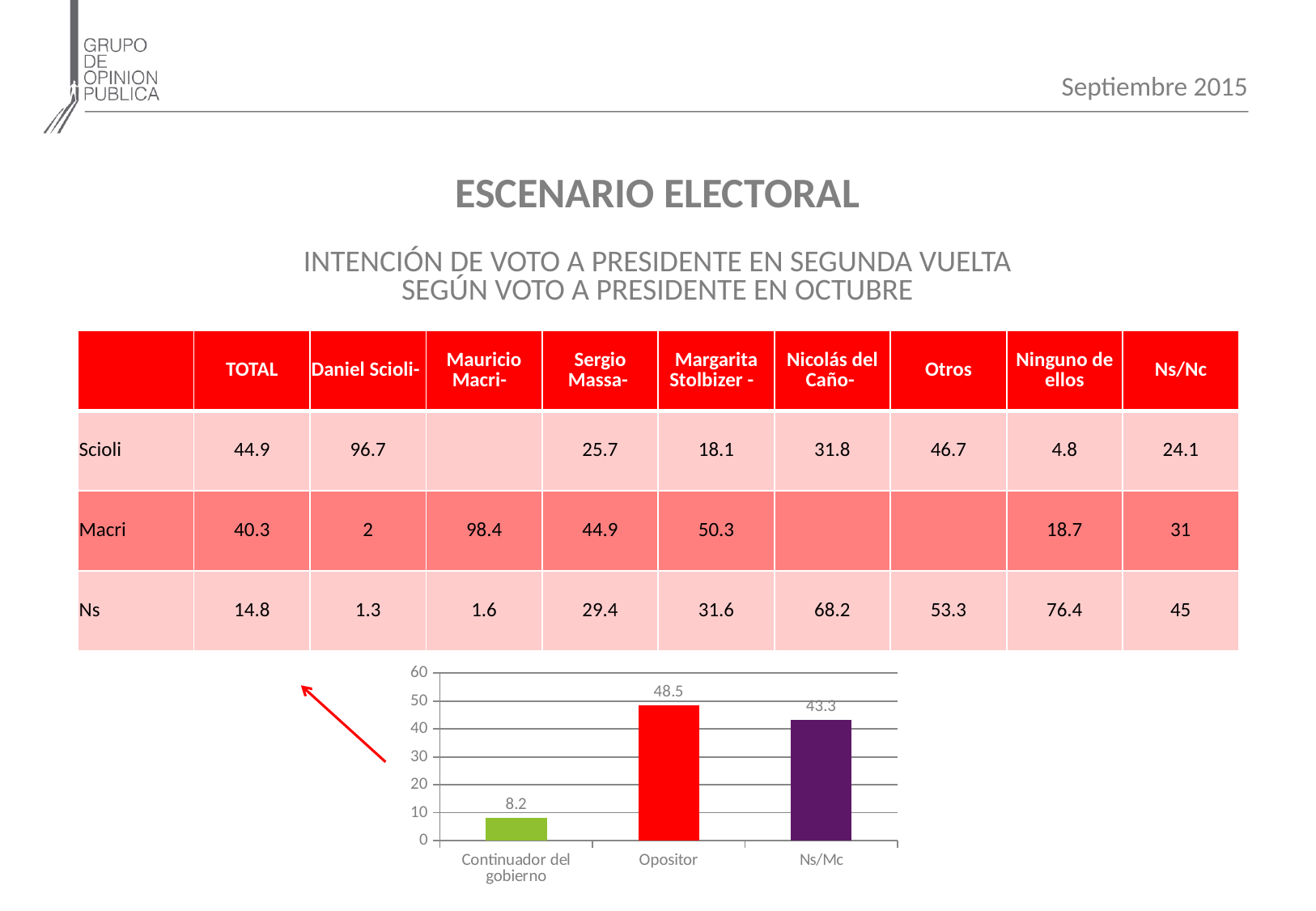
In the bar chart, what colour is the bar for Opositor? red In the bar chart, which is larger, the value for Ns/Mc or the value for Continuador del gobierno? Ns/Mc What kind of chart is shown at the bottom of the slide? bar chart In the bar chart, which category has the lowest value? Continuador del gobierno In the bar chart, what is the difference between the values for Opositor and Ns/Mc? 5.2 In the bar chart, what is the value for Continuador del gobierno? 8.2 How many bars are shown in the bar chart? 3 In the bar chart, what is the value for Ns/Mc? 43.3 In the bar chart, what is the value for Opositor? 48.5 In the bar chart, is the value for Ns/Mc greater or less than 40? greater In the bar chart, which category has the highest value? Opositor In the bar chart, what is the difference between the values for Opositor and Continuador del gobierno? 40.3